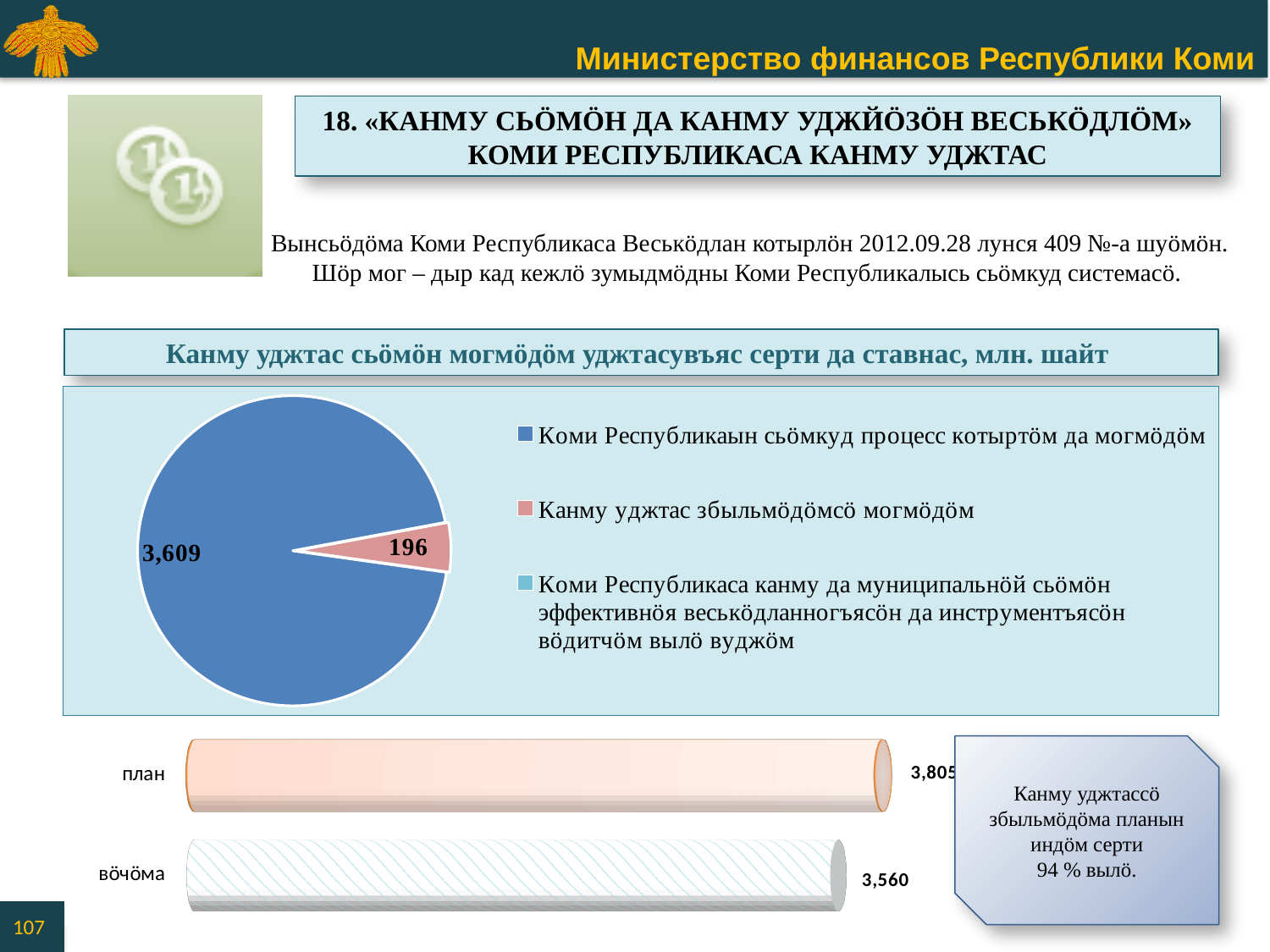
In the pie chart, what value is shown for the pink slice (Канму уджтас збыльмöдöмсö могмöдöм)? 196 In the pie chart, what value is shown for the blue slice (Коми Республикаын сьöмкуд процесс котыртöм да могмöдöм)? 3,609 In the lower bar chart, what is the value for план? 3,805 In the lower bar chart, which is larger, план or вöчöма? план What type of chart is the lower chart on the slide? bar chart What type of chart is the upper chart on the slide? pie chart In the lower bar chart, what is the difference between план and вöчöма? 245 In the lower bar chart, what is the value for вöчöма? 3,560 How many entries does the legend of the pie chart list? 3 In the pie chart, which legend entry has the largest slice? Коми Республикаын сьöмкуд процесс котыртöм да могмöдöм What is the title shown above the pie chart? Канму уджтас сьöмöн могмöдöм уджтасувъяс серти да ставнас, млн. шайт In the pie chart, what is the difference between the two labelled slices, 3,609 and 196? 3,413